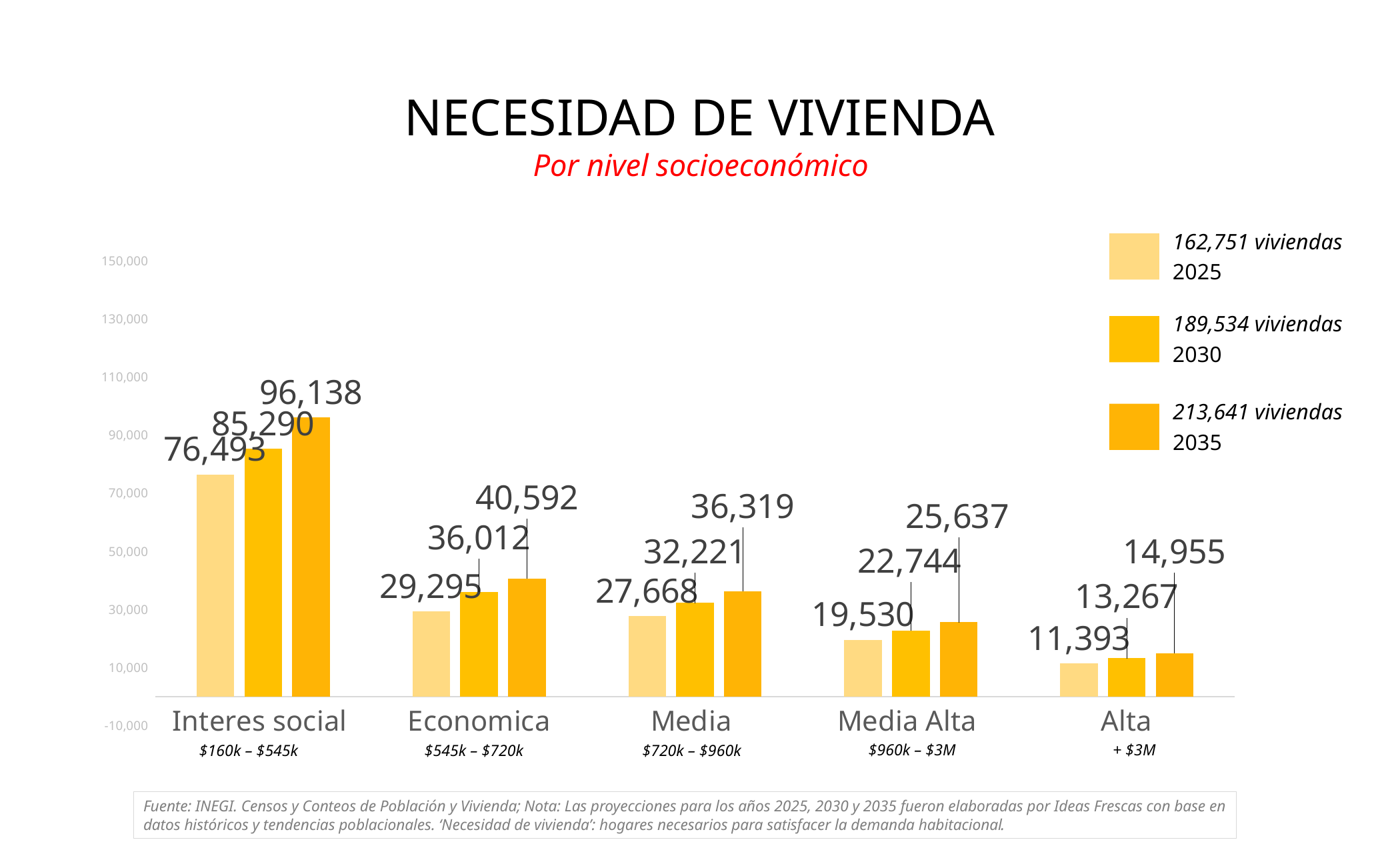
Which is larger: the 2030 value for Media or the 2035 value for Media Alta? Media 2030 Is the 2025 value for Interes social greater or less than 70,000? greater Do the values for Media Alta rise or fall from 2025 to 2035? rise How many series does the legend list? 3 Which category has the lowest value in 2035? Alta What kind of chart is shown? bar chart What is the value for Media in 2025? 27,668 Which category has the highest value in 2030? Interes social How many socioeconomic categories are shown on the x axis? 5 What is the value for Alta in 2030? 13,267 What is the value for Interes social in 2035? 96,138 What is the difference between the 2035 and 2025 values for Economica? 11,297